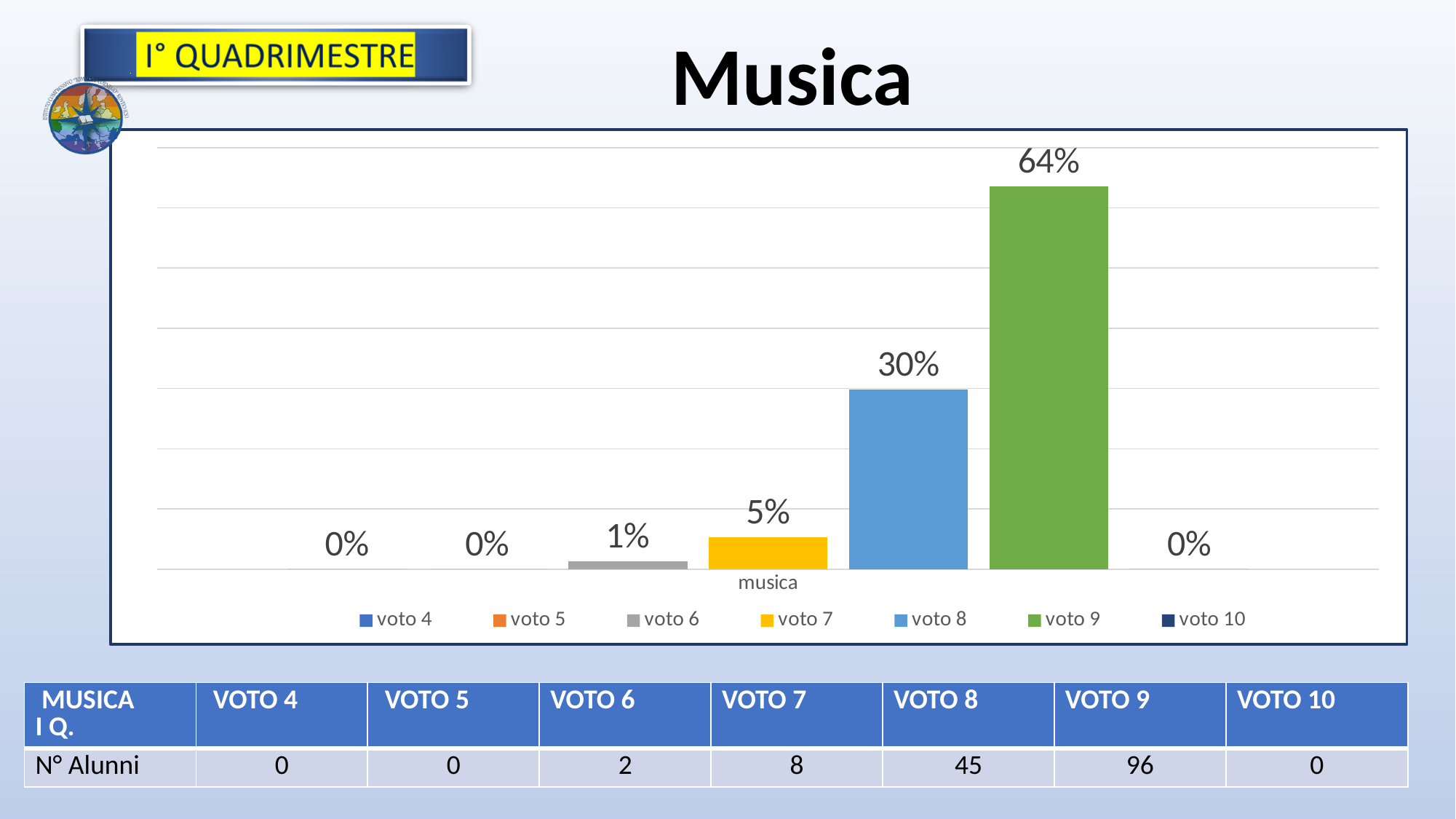
What is the value shown for voto 8? 30% What type of chart is shown on the slide? bar chart What is the difference between the values for voto 9 and voto 8? 34% What is the value shown for voto 10? 0% What is the difference between the values for voto 8 and voto 7? 25% What is the value shown for voto 7? 5% Which series has the highest value in the chart? voto 9 What is the category label shown on the x axis of the chart? musica What is the value shown for voto 9? 64% How many series does the legend list? 7 Which is larger, the value for voto 7 or the value for voto 6? voto 7 What is the value shown for voto 6? 1%